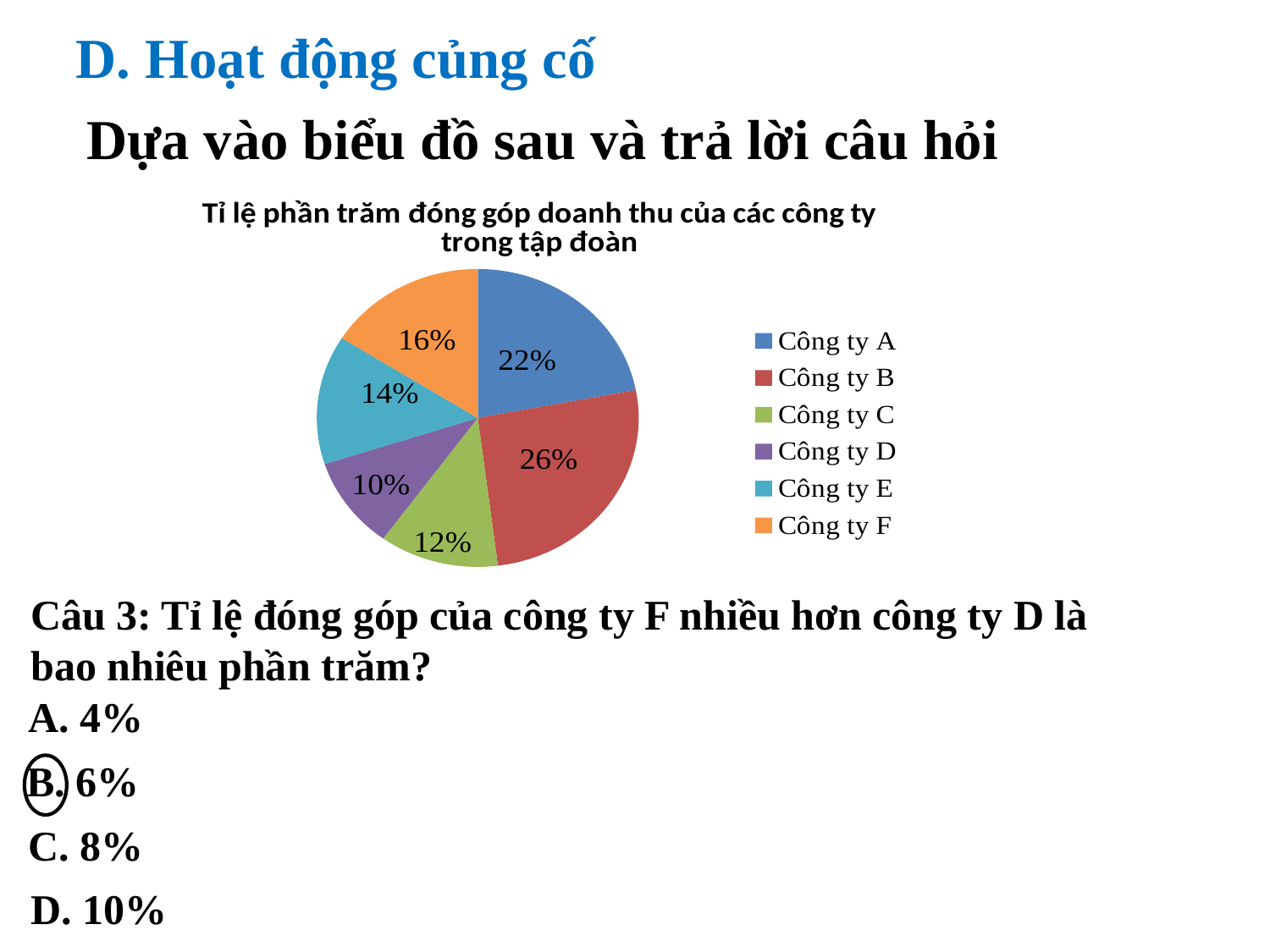
Which company has the smallest share of the pie? Công ty D How many percentage points larger is Công ty F's share than Công ty D's share? 6% What is the percentage share for Công ty D? 10% What is the percentage share for Công ty B? 26% What is the title of the chart? Tỉ lệ phần trăm đóng góp doanh thu của các công ty trong tập đoàn What is the percentage share for Công ty F? 16% What is the percentage share for Công ty A? 22% What kind of chart is shown on the slide? Pie chart Which company has the largest share of the pie? Công ty B What is the difference between the shares of Công ty B and Công ty A? 4% How many companies are shown in the pie chart? 6 Which has a larger share, Công ty C or Công ty E? Công ty E